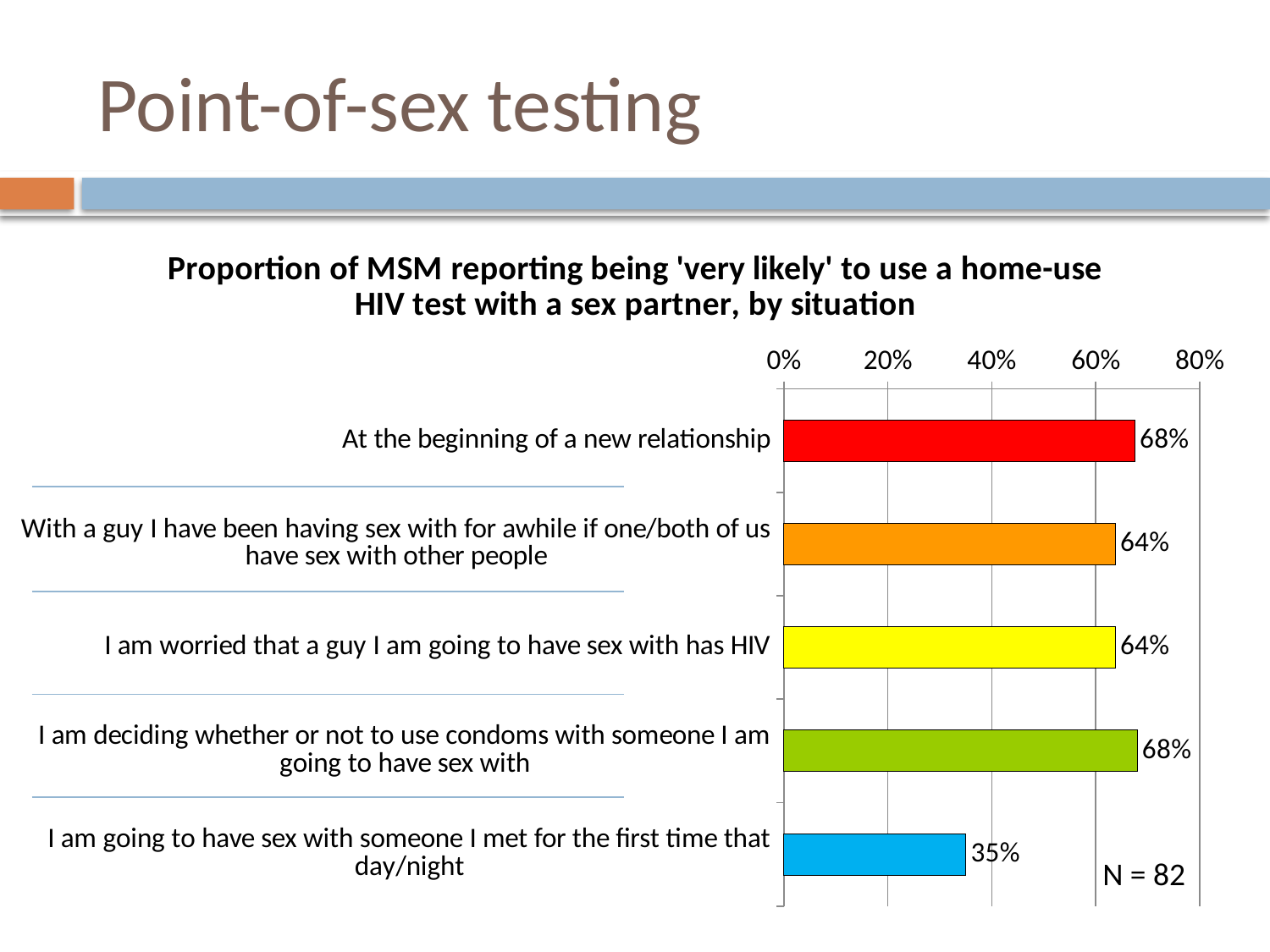
Which is larger: the value for 'At the beginning of a new relationship' or the value for 'I am worried that a guy I am going to have sex with has HIV'? At the beginning of a new relationship What is the title of the chart? Proportion of MSM reporting being 'very likely' to use a home-use HIV test with a sex partner, by situation What is the sample size (N) noted on the chart? N = 82 How many situations (categories) are shown in the chart? 5 What kind of chart is shown on the slide? bar chart Which situation has the lowest proportion of MSM reporting being 'very likely' to use a home-use HIV test? I am going to have sex with someone I met for the first time that day/night What is the difference in percentage points between 'At the beginning of a new relationship' and 'I am going to have sex with someone I met for the first time that day/night'? 33 percentage points What is the value for 'I am worried that a guy I am going to have sex with has HIV'? 64% What is the value for 'I am going to have sex with someone I met for the first time that day/night'? 35% What is the value for 'I am deciding whether or not to use condoms with someone I am going to have sex with'? 68% Is the value for 'With a guy I have been having sex with for awhile if one/both of us have sex with other people' greater or less than 60%? greater What proportion of MSM reported being 'very likely' to use a home-use HIV test at the beginning of a new relationship? 68%